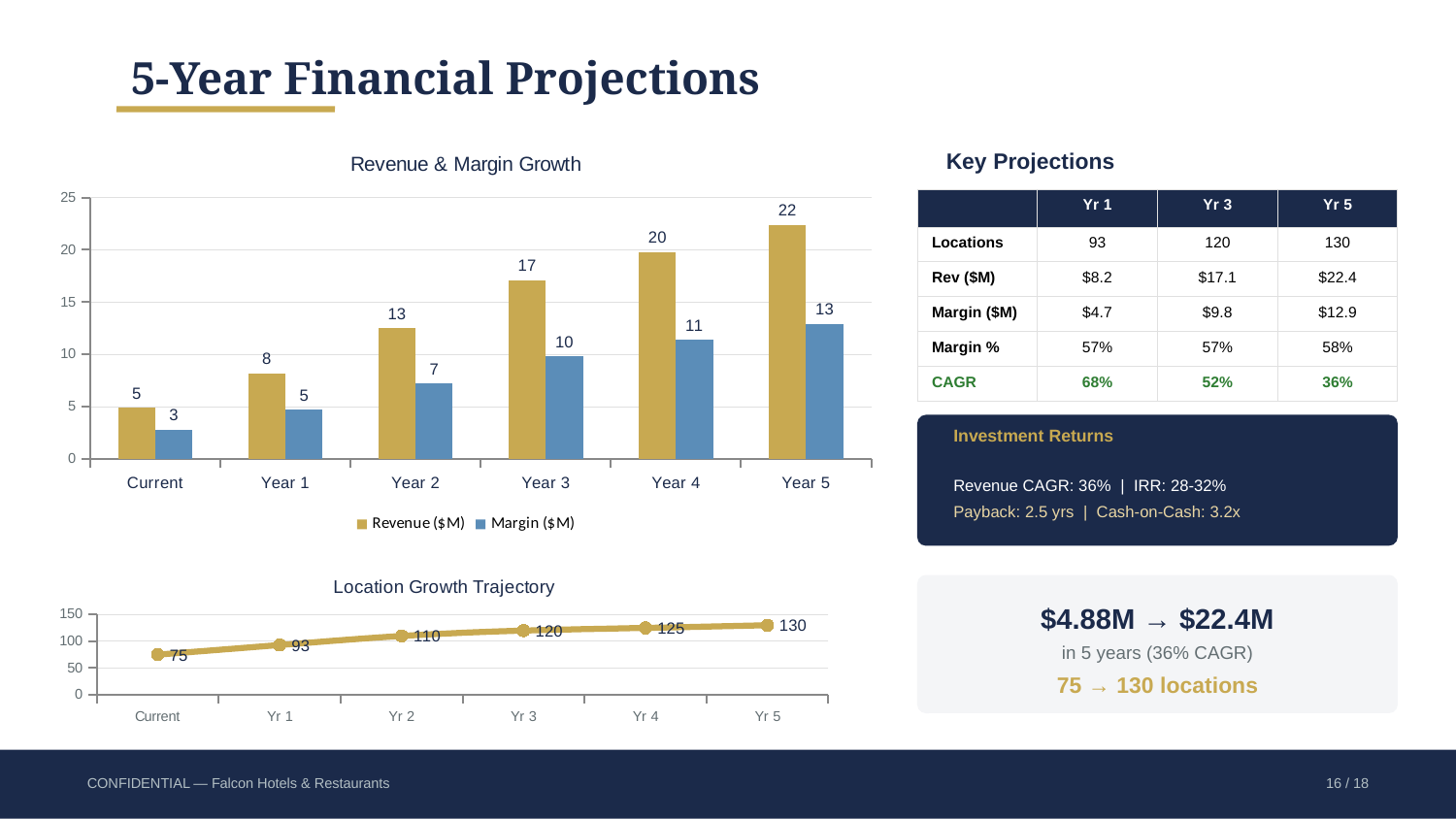
In the Location Growth Trajectory chart, what is the value for Yr 2? 110 In the Revenue & Margin Growth chart, which category has the highest Revenue ($M) value? Year 5 In the Revenue & Margin Growth chart, what is the difference between Revenue ($M) and Margin ($M) in Year 4? 9 In the Location Growth Trajectory chart, do the values rise or fall from Current to Yr 5? Rise In the Revenue & Margin Growth chart, which is larger: Revenue ($M) in Year 2 or Margin ($M) in Year 5? Revenue ($M) in Year 2 What kind of chart is the Revenue & Margin Growth chart? Bar chart In the Location Growth Trajectory chart, how many data points are plotted? 6 In the Location Growth Trajectory chart, what is the difference between the Yr 5 value and the Current value? 55 In the Revenue & Margin Growth chart, what is the Revenue ($M) value for Year 3? 17 How many series does the legend of the Revenue & Margin Growth chart list? 2 In the Revenue & Margin Growth chart, what is the Margin ($M) value for Year 5? 13 In the Revenue & Margin Growth chart, which category has the lowest Margin ($M) value? Current